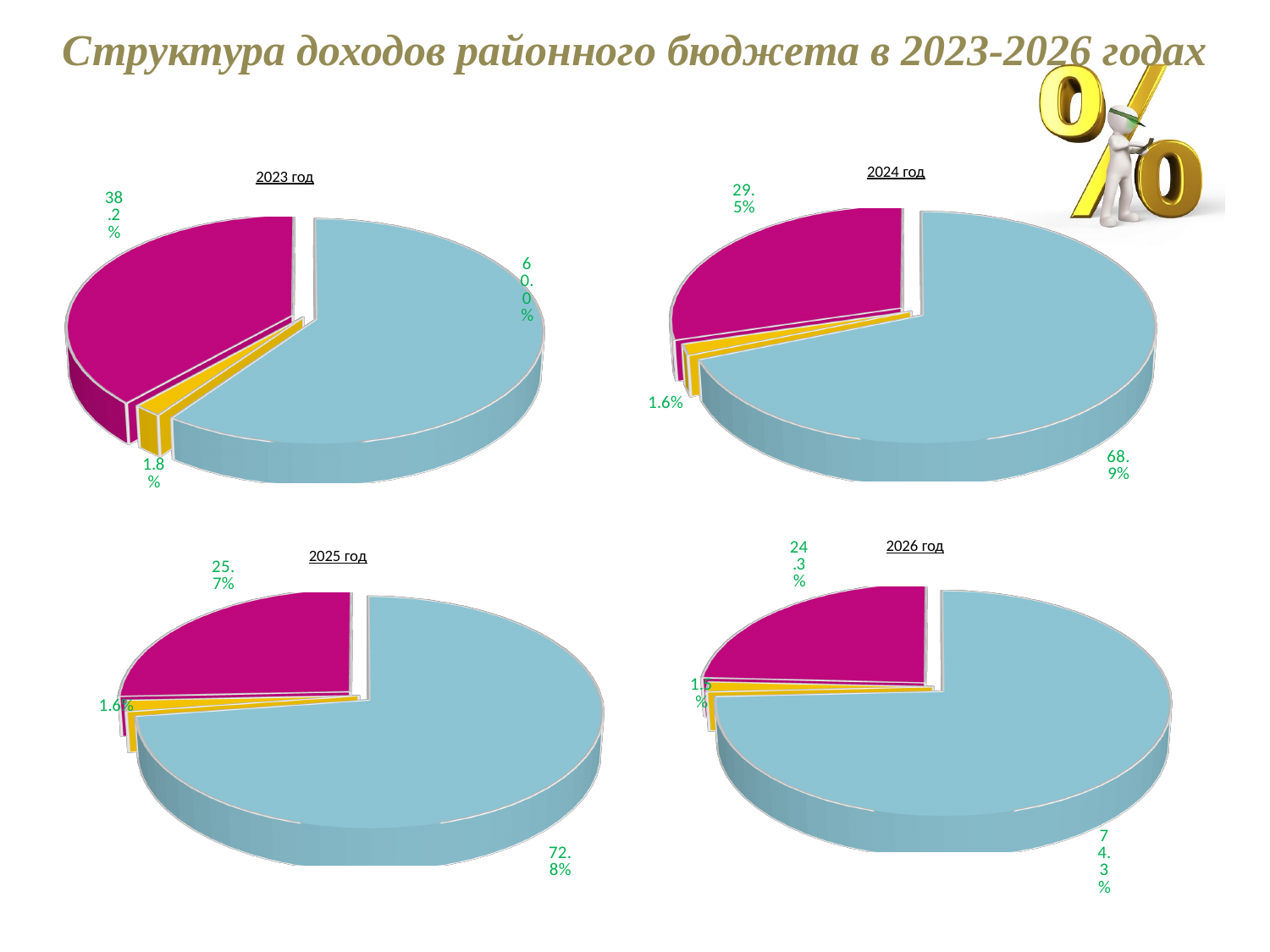
In the 2026 год pie chart, what percentage is shown for the magenta slice? 24.3% In the 2023 год pie chart, what percentage is shown for the light blue slice? 60.0% How many pie charts are on the slide? 4 In the 2025 год pie chart, what percentage is shown for the light blue slice? 72.8% In the 2026 год pie chart, which slice is the largest? the light blue slice (74.3%) In the 2024 год pie chart, what percentage is shown for the light blue slice? 68.9% In the 2024 год pie chart, what percentage is shown for the magenta slice? 29.5% In the 2023 год pie chart, what percentage is shown for the magenta slice? 38.2% In the 2023 год pie chart, what is the difference between the light blue slice and the magenta slice? 21.8% In the 2025 год pie chart, what percentage is shown for the yellow slice? 1.6% In the 2023 год pie chart, what percentage is shown for the yellow slice? 1.8% What kind of chart is used for 2024 год? pie chart